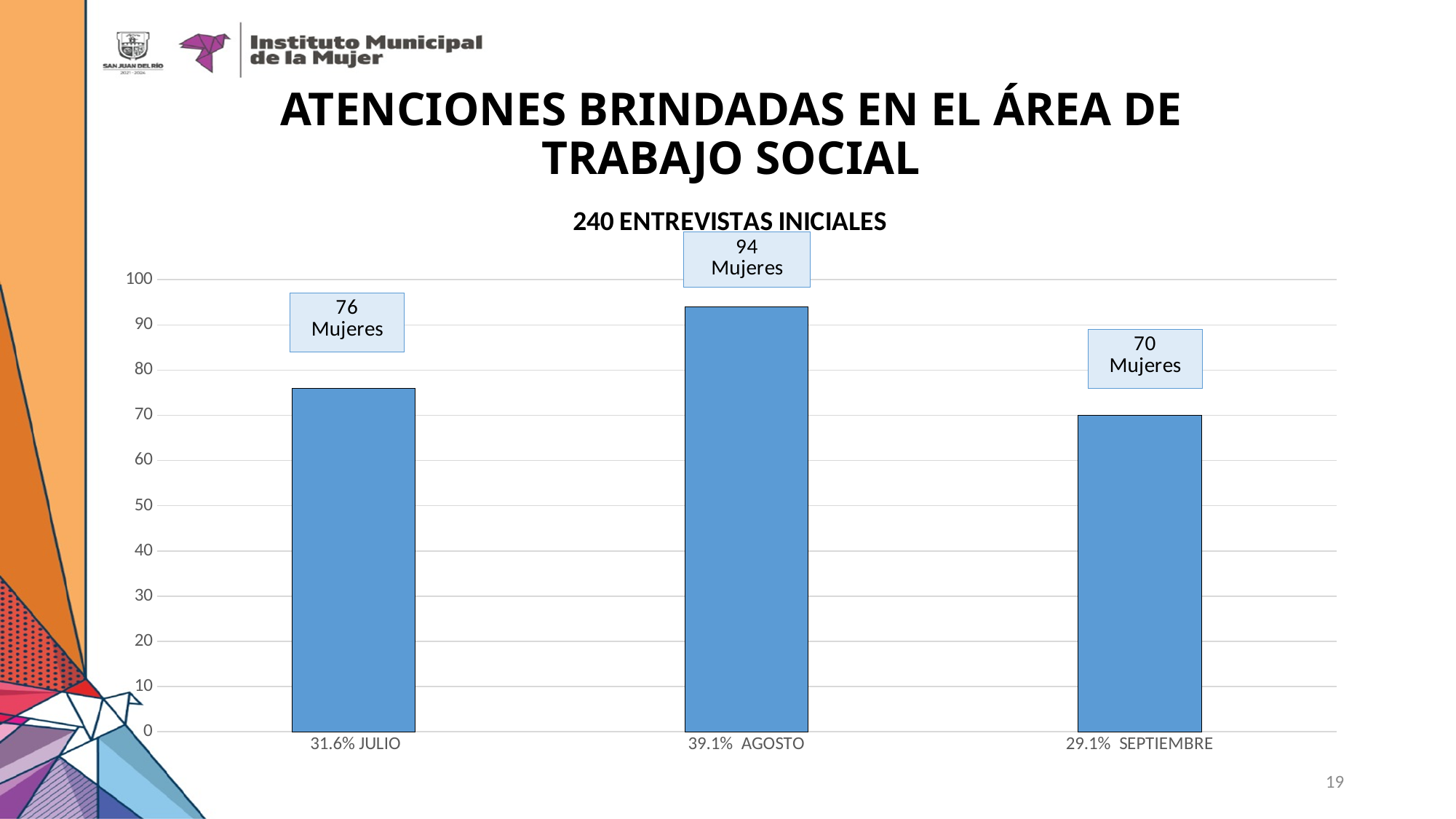
What is the value for SEPTIEMBRE? 70 Mujeres Which month has the lowest value? SEPTIEMBRE What is the title of the chart? 240 ENTREVISTAS INICIALES What is the difference between the values for JULIO and SEPTIEMBRE? 6 Which month has the highest value? AGOSTO What is the value for AGOSTO? 94 Mujeres What is the difference between the values for AGOSTO and JULIO? 18 What kind of chart is shown on the slide? bar chart What is the value for JULIO? 76 Mujeres What percentage is shown next to AGOSTO on the x axis? 39.1% Which is larger, the value for JULIO or the value for SEPTIEMBRE? JULIO How many months are shown on the chart? 3